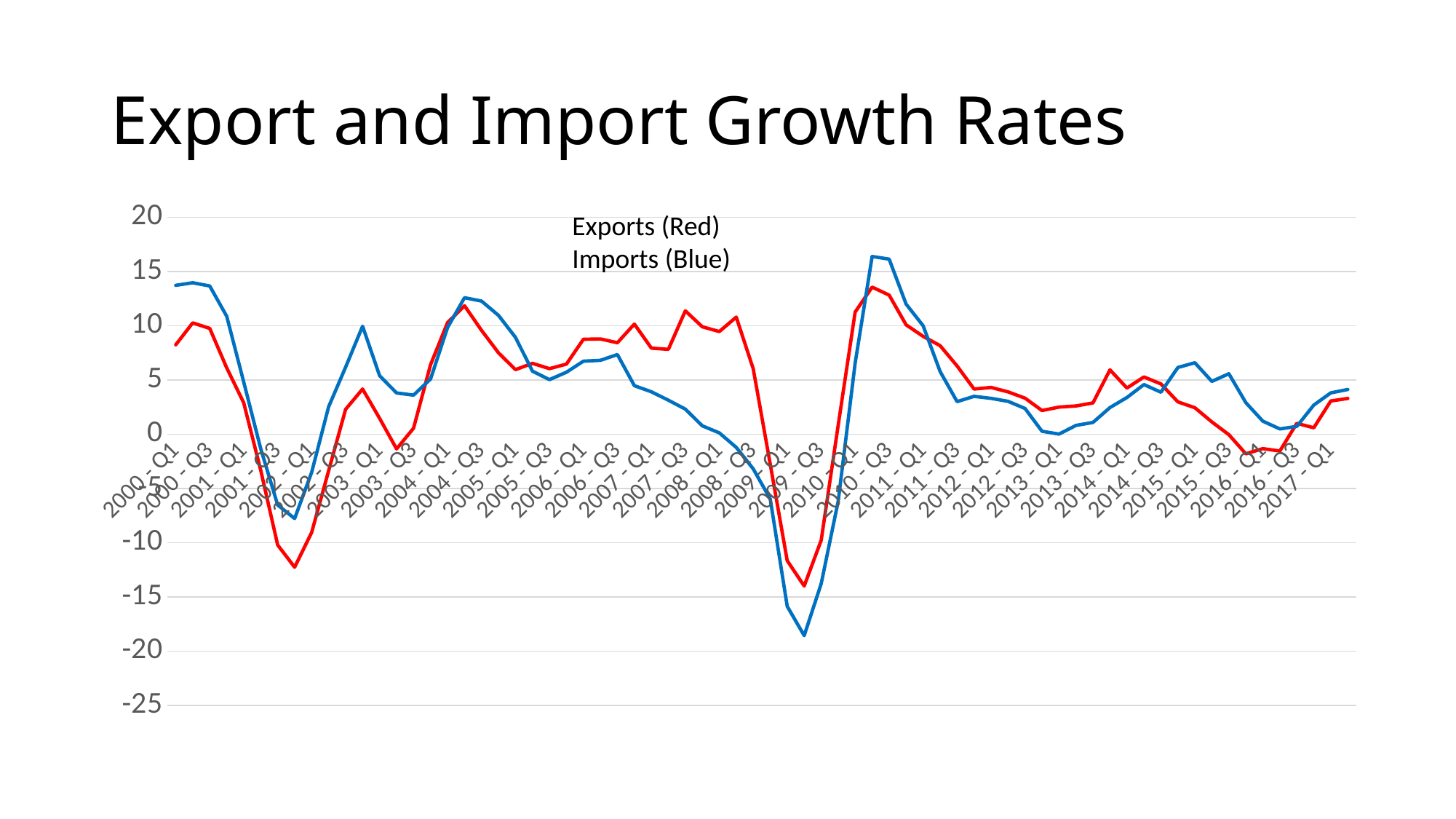
Is the value for Exports at 2002 - Q1 greater or less than -10? greater What kind of chart is shown on the slide? line chart Is the value for Imports at 2010 - Q3 greater or less than 15? greater Is the value for Exports at 2000 - Q1 greater or less than 10? less At 2000 - Q1, which series has the higher value, Exports or Imports? Imports Which colour represents Imports in the chart? Blue Do the Imports values rise or fall from 2000 - Q1 to 2002 - Q1? fall How many series does the chart show? 2 What is the title of the chart on the slide? Export and Import Growth Rates Which series reaches the lowest value anywhere on the chart? Imports (Blue)